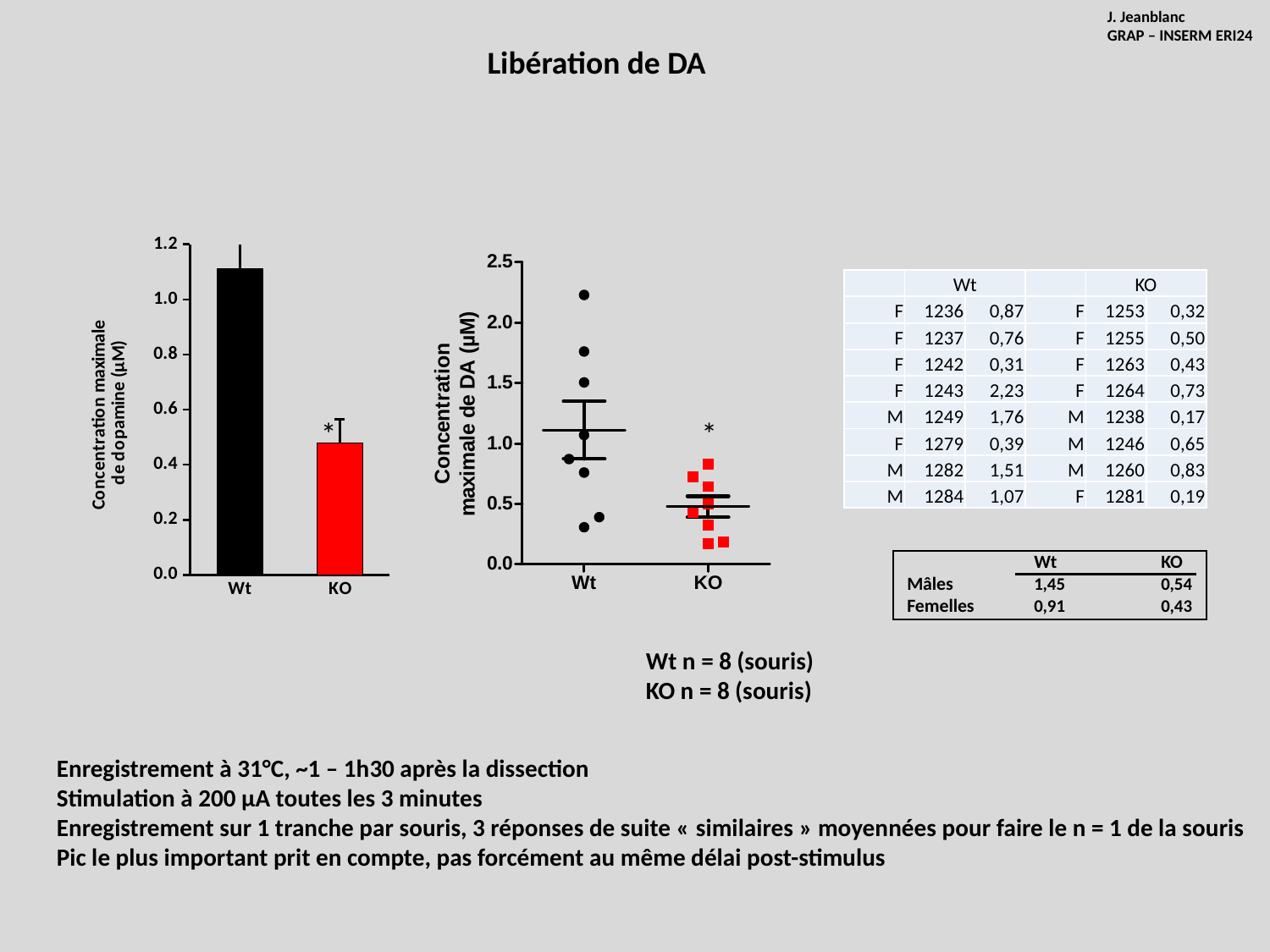
What is the y-axis label of the left bar chart? Concentration maximale de dopamine (µM) What colour is the KO bar in the left bar chart? red In the middle scatter plot, is the highest Wt point greater or less than 2.0? greater How many categories are shown on the x axis of the left bar chart? 2 In the left bar chart, is the value for KO greater or less than 0.6? less In the left bar chart, which category has the higher value, Wt or KO? Wt In the middle scatter plot, is the highest KO point greater or less than 1.0? less What kind of chart is the middle chart on the slide? scatter (dot) plot What kind of chart is the left chart on the slide? bar chart In the middle scatter plot, how many data points are plotted for the Wt group? 8